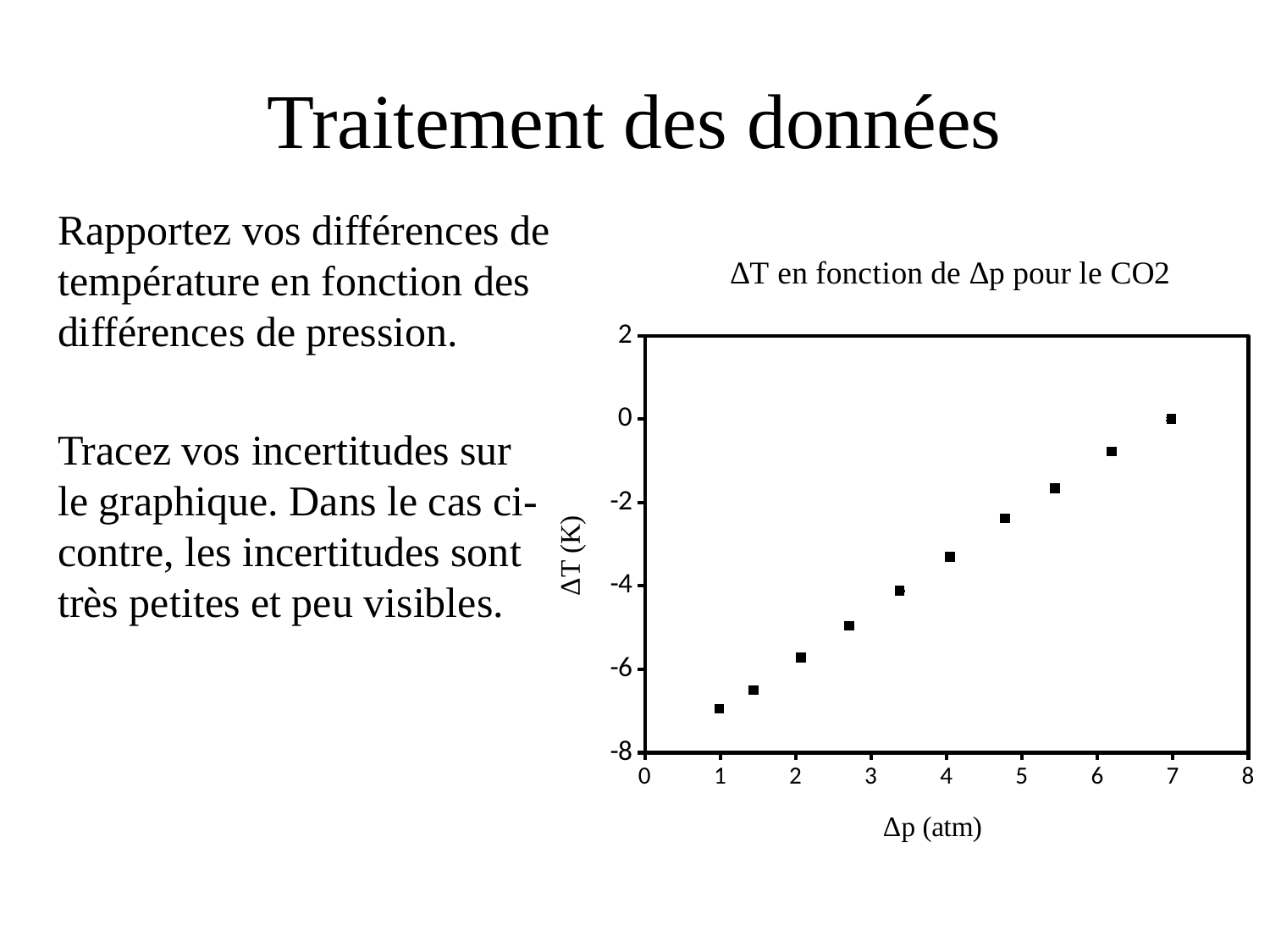
What kind of chart is shown on the slide? Scatter plot What is the title of the chart? ΔT en fonction de Δp pour le CO2 At which Δp value is the lowest ΔT plotted? 1 atm Is the ΔT value for the point at Δp = 4 atm greater or less than -4 K? greater Do the ΔT values rise or fall as Δp increases along the x axis? Rise Is the ΔT value for the point at Δp = 7 atm greater or less than -2 K? greater Is the ΔT value for the point at Δp = 2 atm greater or less than -4 K? less At which Δp value is the highest ΔT plotted? 7 atm What is the label of the x axis of the chart? Δp (atm) Which point has the larger ΔT: the one at Δp = 7 atm or the one at Δp = 1 atm? Δp = 7 atm How many data points are plotted on the chart? 10